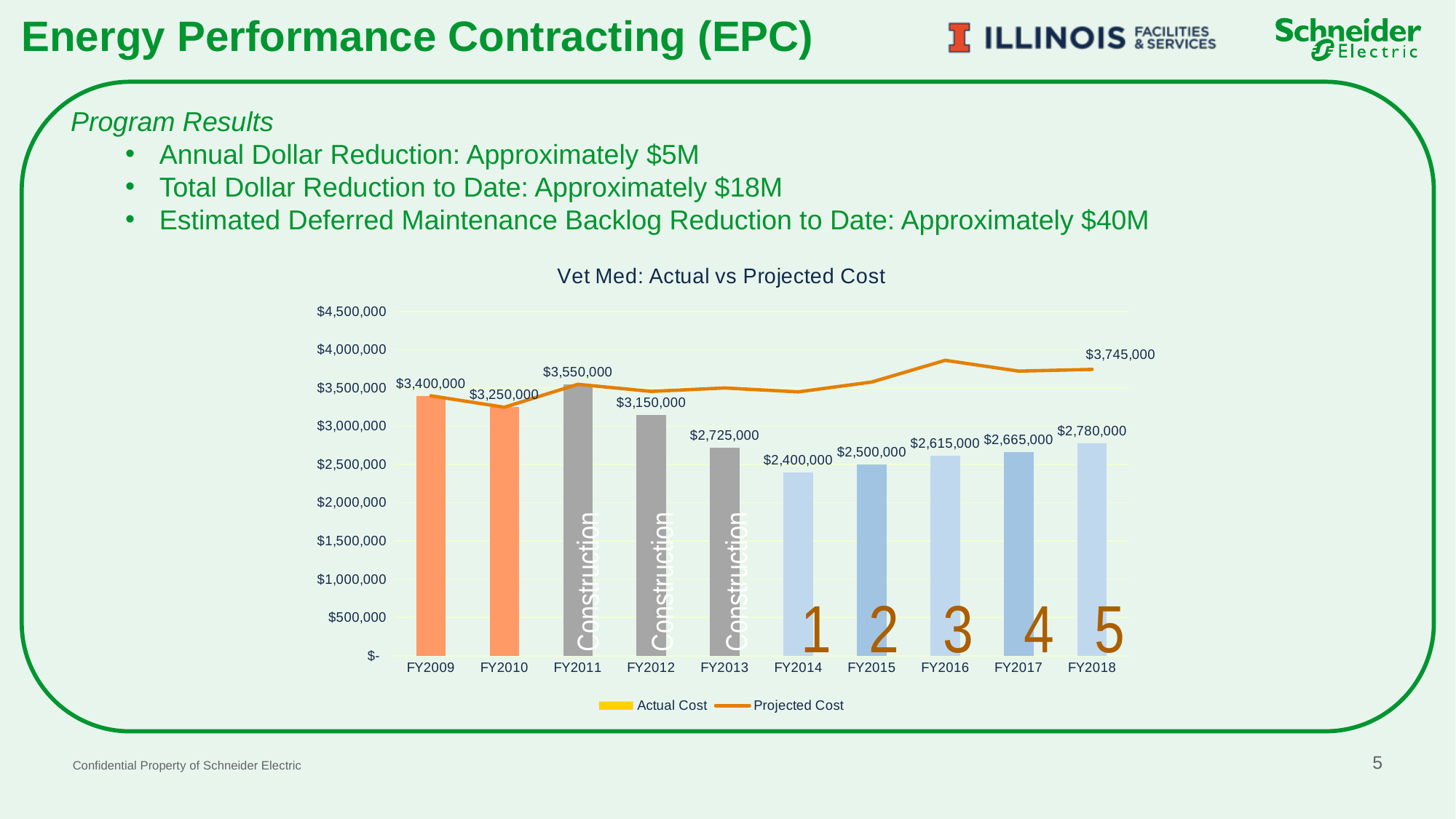
Which fiscal year has the highest actual cost? FY2011 What is the actual cost for FY2014? $2,400,000 Which is larger, the actual cost in FY2012 or the actual cost in FY2013? FY2012 What is the difference between the actual cost in FY2009 and the actual cost in FY2018? $620,000 What is the actual cost for FY2011? $3,550,000 How many series does the legend list? 2 Do the actual cost values rise or fall from FY2014 to FY2018? rise Which fiscal year has the lowest actual cost? FY2014 What is the difference between the projected cost and the actual cost in FY2018? $965,000 Is the projected cost for FY2014 greater or less than $3,000,000? greater How many fiscal years are shown on the x axis? 10 What is the projected cost labelled for FY2018? $3,745,000